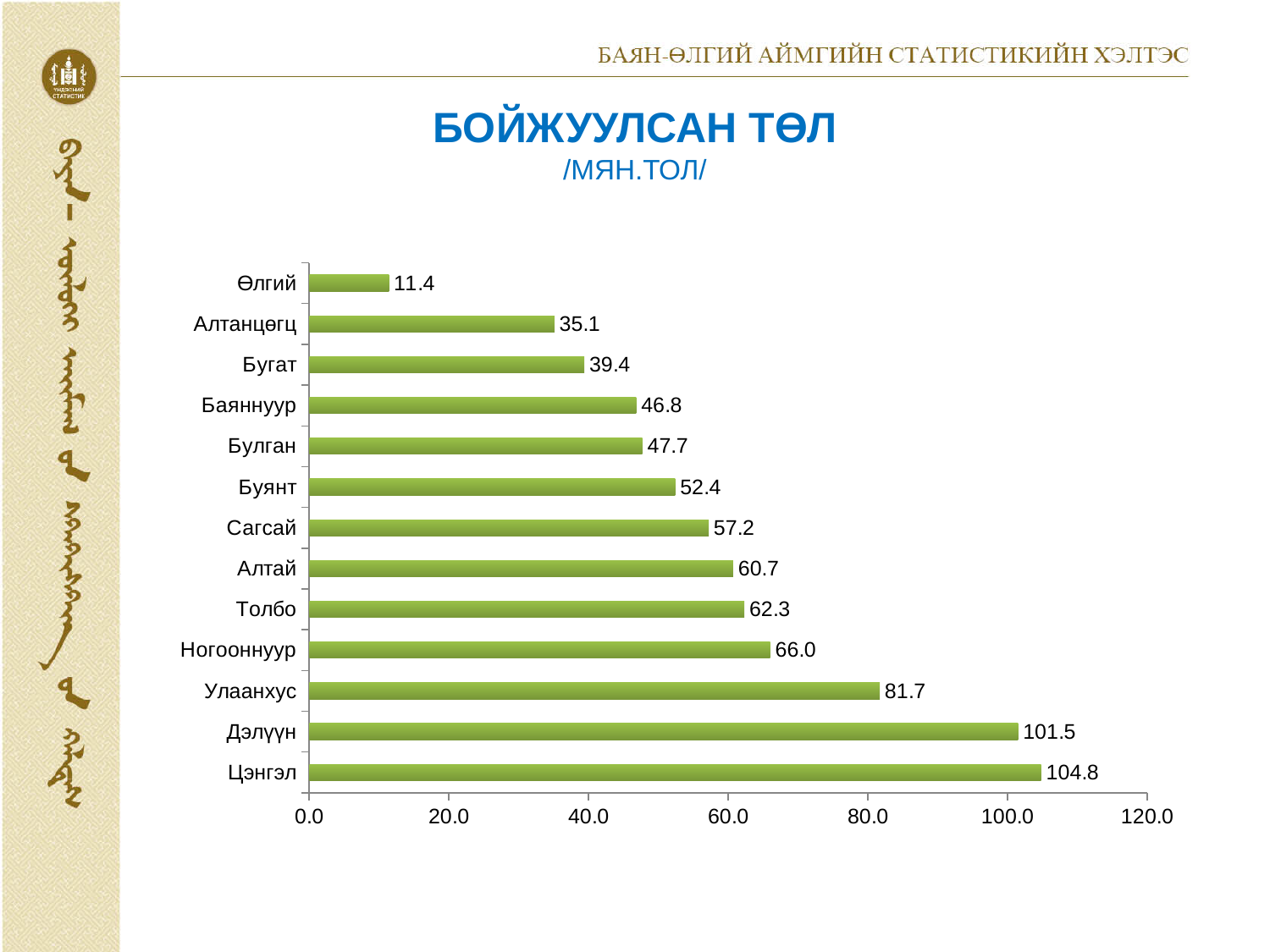
How many categories are shown in the chart? 13 What is the difference between the values for Дэлүүн and Улаанхус? 19.8 What is the value for Өлгий? 11.4 What is the value for Цэнгэл? 104.8 What is the maximum value shown on the horizontal axis? 120.0 Is the value for Толбо greater or less than 60.0? greater What is the title of the chart? БОЙЖУУЛСАН ТӨЛ What kind of chart is shown on the slide? bar chart Which category has the lowest value? Өлгий Which category has the highest value? Цэнгэл What is the value for Ногооннуур? 66.0 Which is larger, the value for Сагсай or the value for Буянт? Сагсай